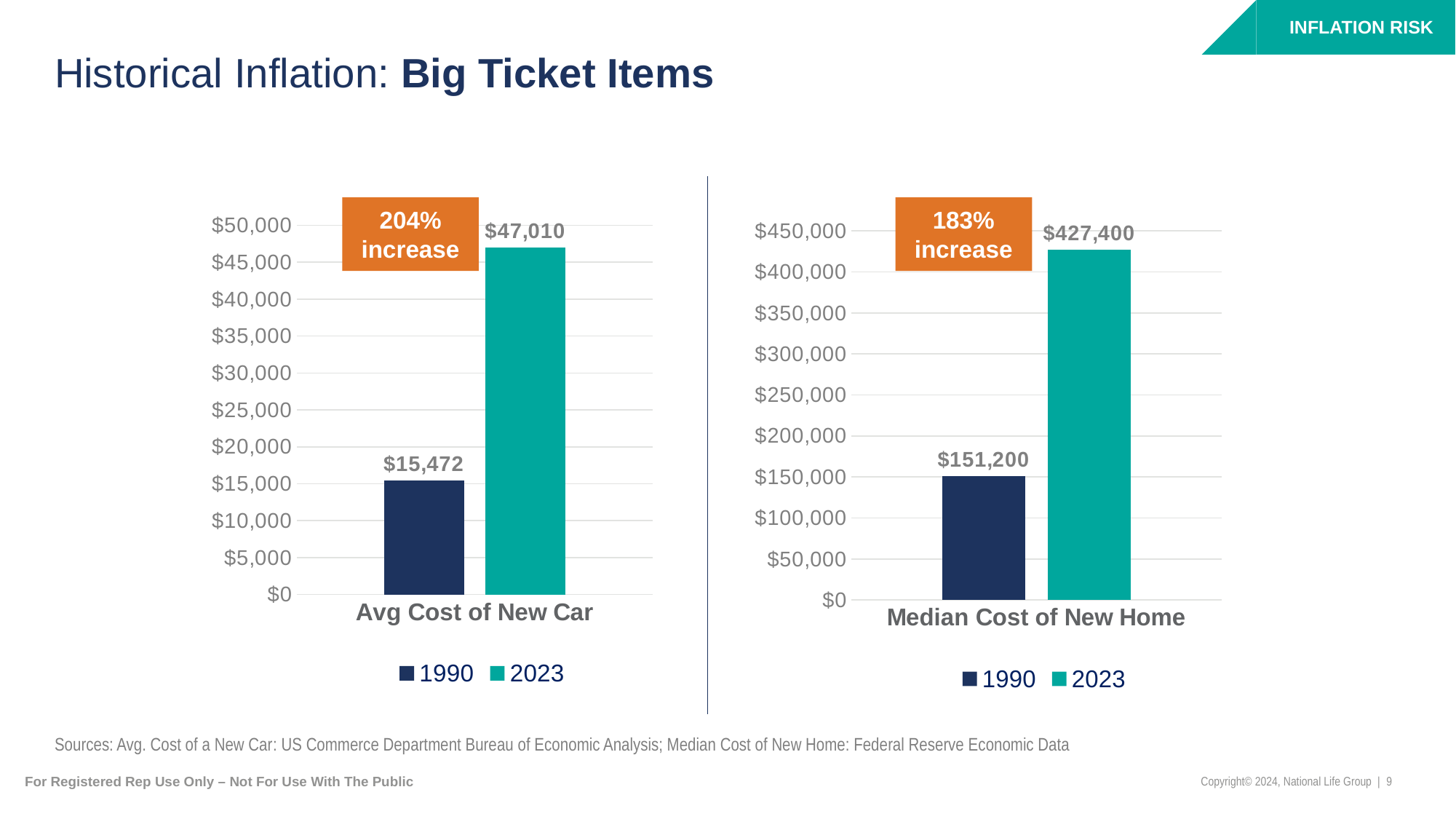
What kind of chart is the Median Cost of New Home chart? Bar chart In the Avg Cost of New Car chart, what is the value for 2023? $47,010 In the Avg Cost of New Car chart, which series has the higher value, 1990 or 2023? 2023 In the Median Cost of New Home chart, what is the value for 1990? $151,200 In the Median Cost of New Home chart, what is the difference between the 2023 and 1990 values? $276,200 In the Avg Cost of New Car chart, what is the difference between the 2023 and 1990 values? $31,538 In the Median Cost of New Home chart, what percentage increase is shown in the orange callout? 183% increase In the Avg Cost of New Car chart, what is the value for 1990? $15,472 In the Median Cost of New Home chart, which series has the lowest value? 1990 In the Median Cost of New Home chart, what is the value for 2023? $427,400 In the Avg Cost of New Car chart, what percentage increase is shown in the orange callout? 204% increase How many series does the legend of the Avg Cost of New Car chart list? 2